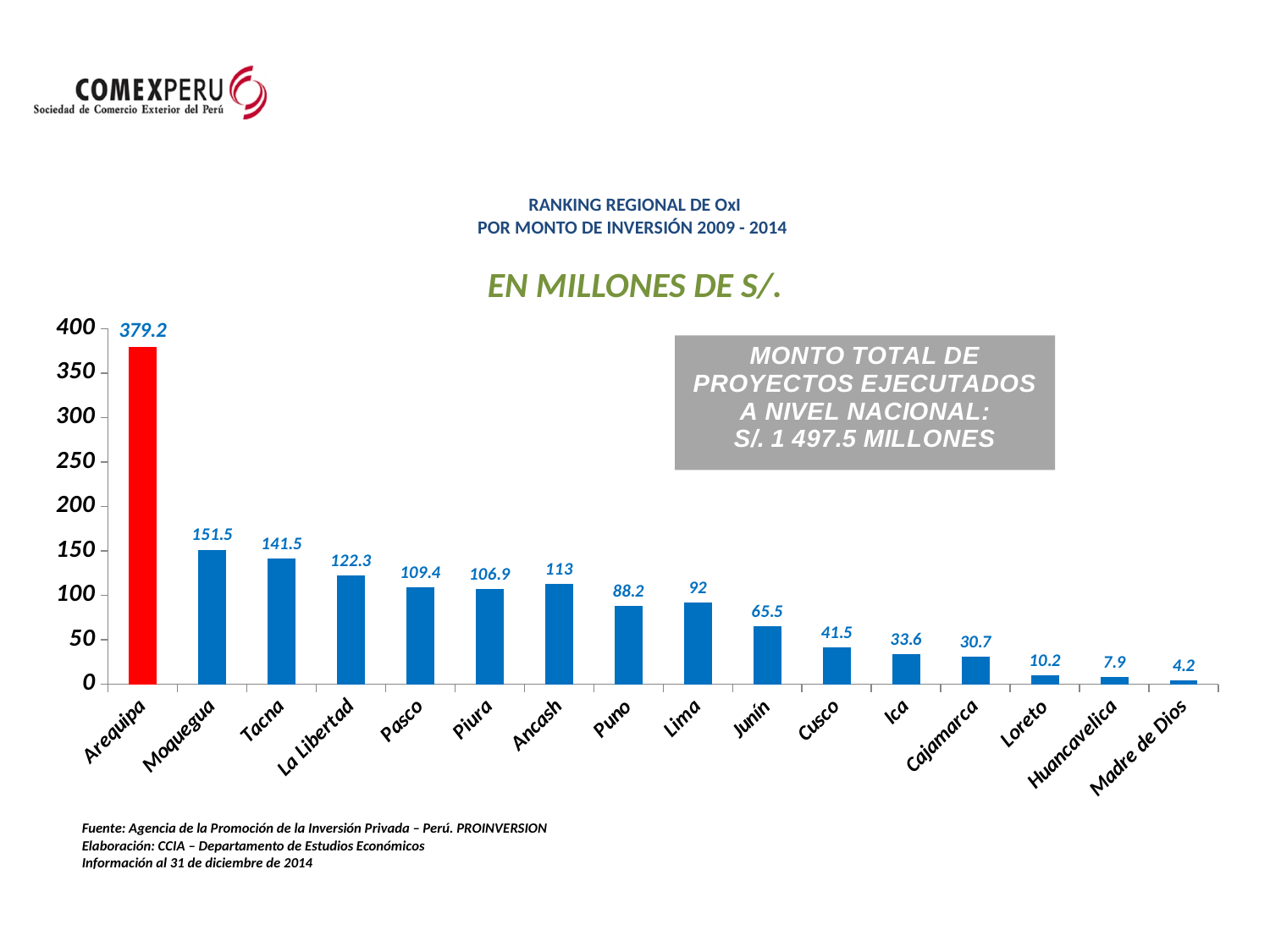
What is the value for Ancash? 113 What is the value for Arequipa? 379.2 What kind of chart is shown on the slide? bar chart What is the difference between the values for Arequipa and Moquegua? 227.7 Which region has the lowest value? Madre de Dios What is the difference between the values for Moquegua and Tacna? 10 What is the value for Cajamarca? 30.7 Which is larger, the value for Lima or the value for Puno? Lima Which region has the highest value? Arequipa How many regions are shown on the chart? 16 Is the value for Junín greater or less than 100? less What total amount is stated in the grey box on the chart? S/. 1 497.5 MILLONES